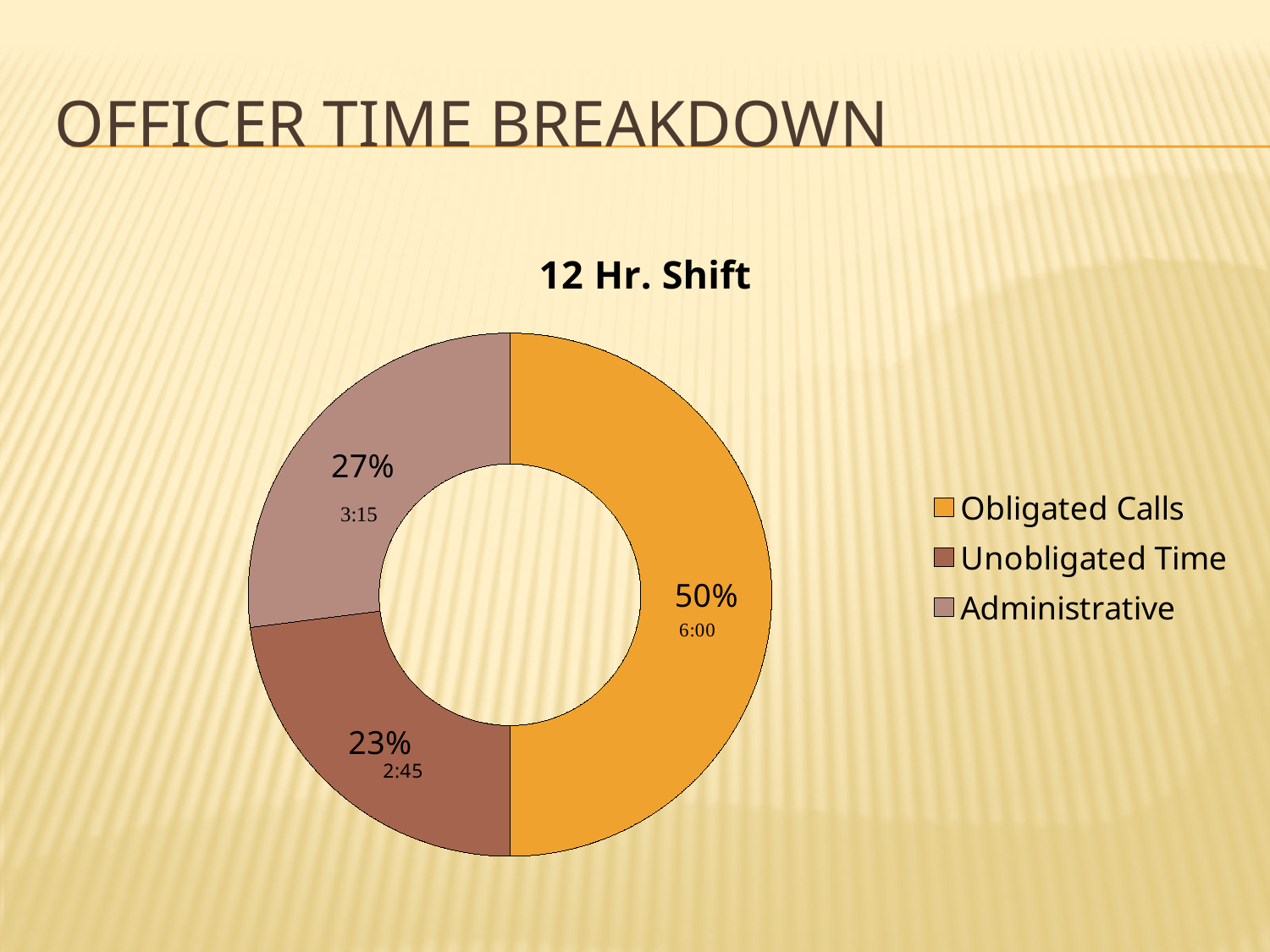
What is the title of the chart? 12 Hr. Shift How much time is labelled for the Obligated Calls slice? 6:00 What is the difference in percentage points between Obligated Calls and Administrative? 23 How many categories does the chart show? 3 Which category takes the largest share of the 12 Hr. Shift? Obligated Calls What percentage of the 12 Hr. Shift is Unobligated Time? 23% Which is larger, the Administrative share or the Unobligated Time share? Administrative How much time is labelled for the Administrative slice? 3:15 Which category takes the smallest share of the 12 Hr. Shift? Unobligated Time What percentage of the 12 Hr. Shift is Administrative? 27% What kind of chart is shown on the slide? Doughnut (pie) chart What percentage of the 12 Hr. Shift is Obligated Calls? 50%